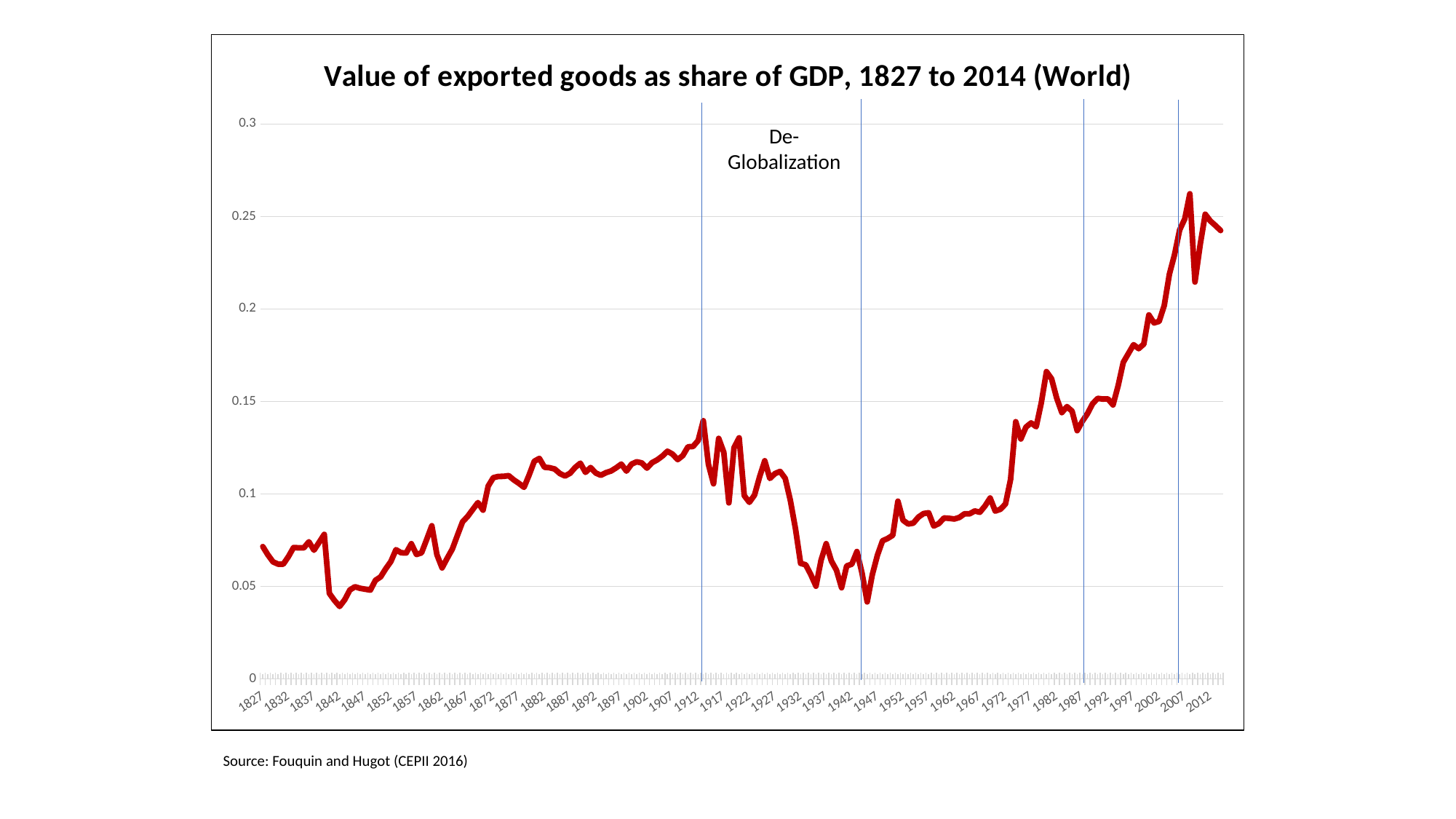
What label is written between the vertical lines at 1912 and 1947 on the chart? De-Globalization What kind of chart is shown on the slide? line chart Is the value for 1982 greater or less than 0.1? greater Is the highest value reached by the line greater or less than 0.25? greater Does the value generally rise or fall between 1912 and 1942? fall Does the value generally rise or fall between 1947 and 2007? rise Is the value for 1912 greater or less than 0.15? less What is the title of the chart? Value of exported goods as share of GDP, 1827 to 2014 (World)